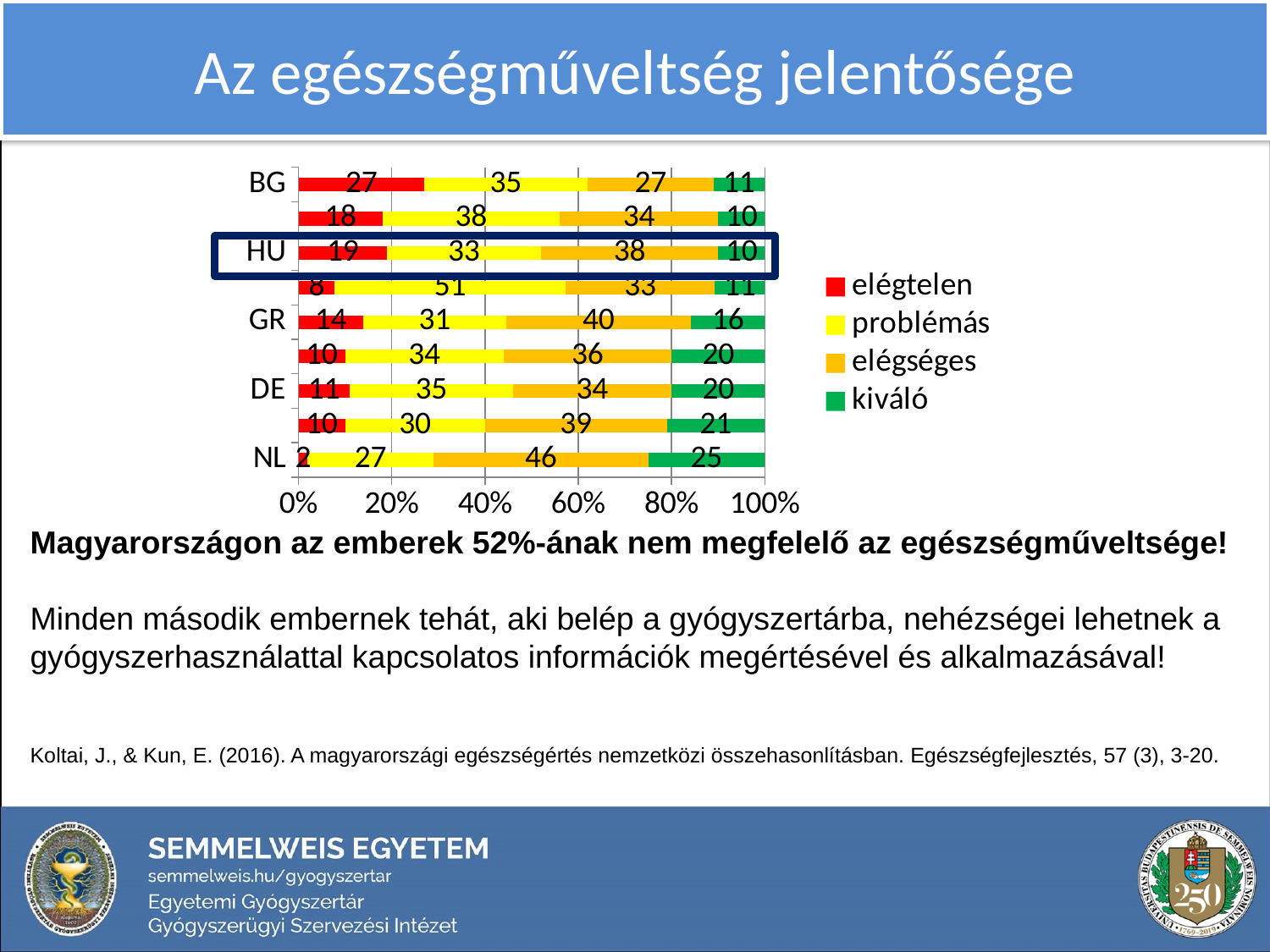
What kind of chart is shown on the slide? Stacked bar chart What is the value of the elégtelen segment for HU? 19 What is the value of the problémás segment for BG? 35 What is the difference between the elégséges values for HU and BG? 11 Which labelled country has the highest elégtelen value? BG What is the total of the four segments in the NL bar? 100 What is the value of the kiváló segment for NL? 25 Which has the larger kiváló value, DE or HU? DE What colour represents the kiváló series in the legend? Green What is the value of the elégséges segment for GR? 40 Which labelled country has the lowest elégtelen value? NL How many series does the legend list? 4